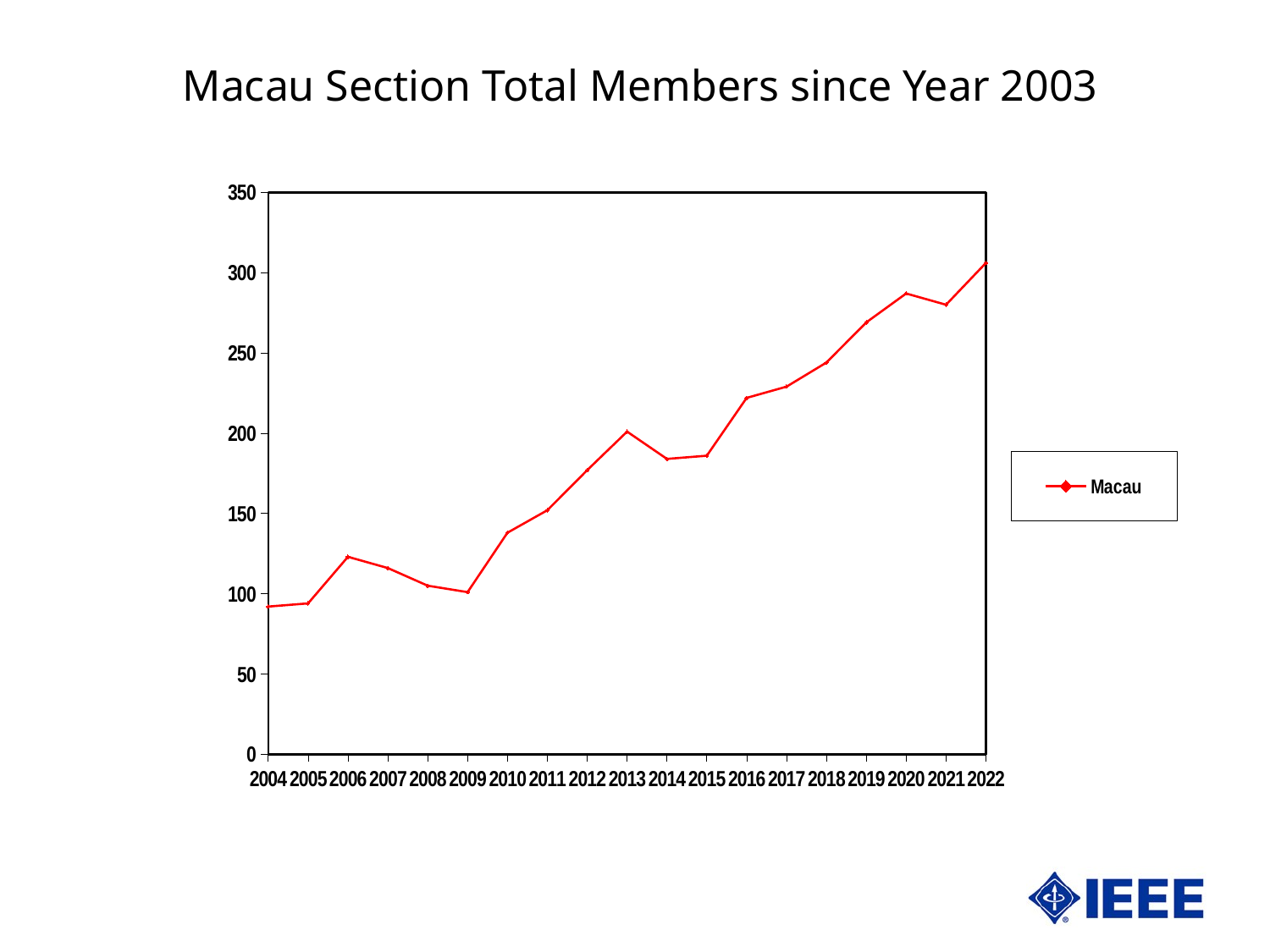
Is the value for 2010 greater or less than 150? less Which is larger, the value for 2020 or the value for 2021? 2020 Which is larger, the value for 2006 or the value for 2009? 2006 What kind of chart is shown on the slide? line chart Is the value for 2004 greater or less than 100? less Which year has the highest number of members? 2022 Overall, do the values rise or fall from 2004 to 2022? rise Is the value for 2022 greater or less than 300? greater How many series does the legend list? 1 How many years are plotted along the x axis? 19 What is the title of the chart? Macau Section Total Members since Year 2003